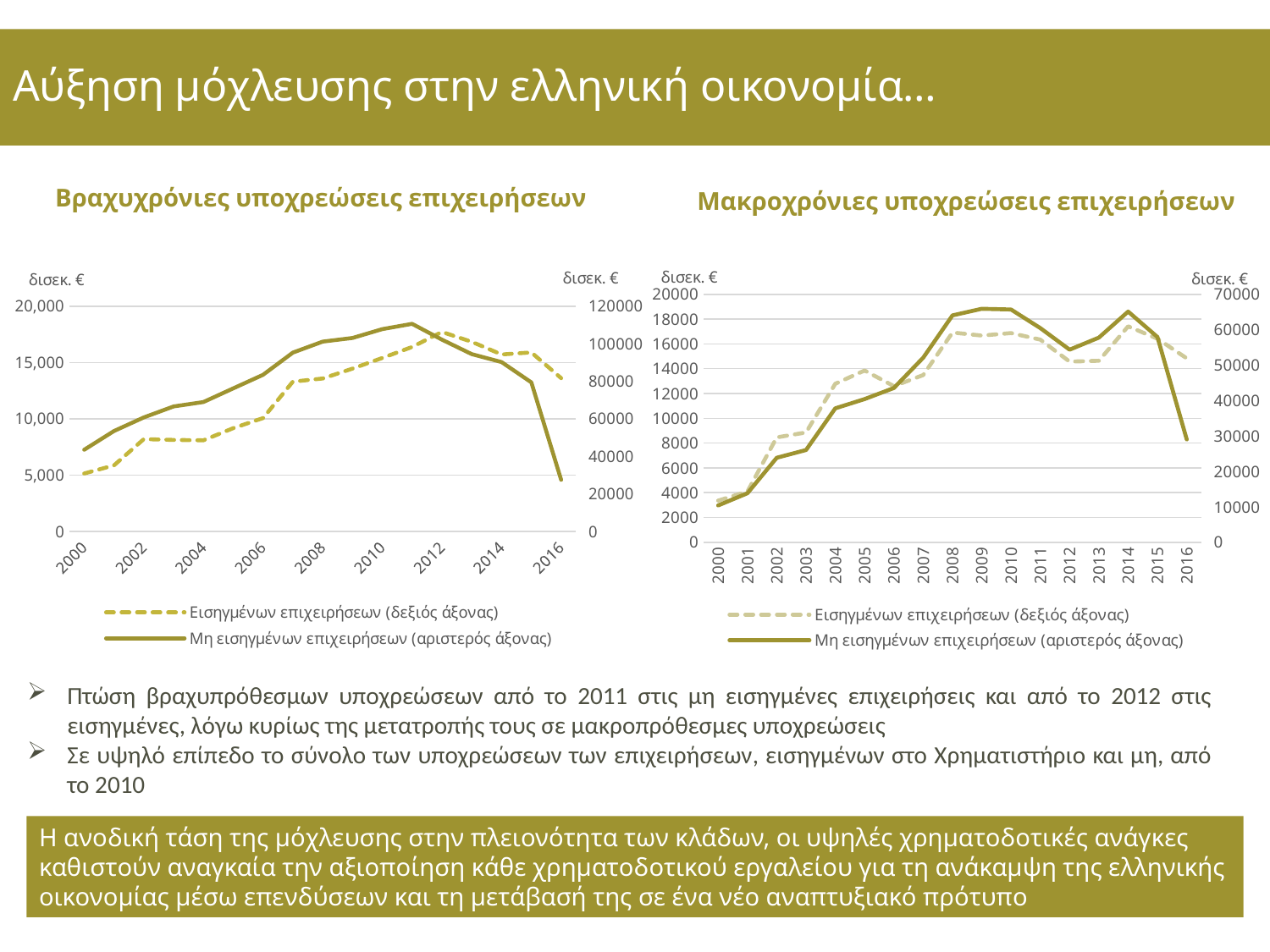
In the right chart 'Μακροχρόνιες υποχρεώσεις επιχειρήσεων', how many years are shown on the x axis? 17 In the left chart 'Βραχυχρόνιες υποχρεώσεις επιχειρήσεων', is the value of the solid line (Μη εισηγμένων επιχειρήσεων) in 2016 greater or less than 10,000? less In the left chart 'Βραχυχρόνιες υποχρεώσεις επιχειρήσεων', is the value of the solid line (Μη εισηγμένων επιχειρήσεων) in 2011 greater or less than 15,000? greater What type of chart is the left chart titled 'Βραχυχρόνιες υποχρεώσεις επιχειρήσεων'? Line chart In the right chart 'Μακροχρόνιες υποχρεώσεις επιχειρήσεων', is the value of the solid line (Μη εισηγμένων επιχειρήσεων) in 2016 greater or less than 10000? less In the right chart 'Μακροχρόνιες υποχρεώσεις επιχειρήσεων', does the solid line (Μη εισηγμένων επιχειρήσεων) rise or fall between 2000 and 2009? rise How many series does the legend of the right chart 'Μακροχρόνιες υποχρεώσεις επιχειρήσεων' list? 2 In the right chart 'Μακροχρόνιες υποχρεώσεις επιχειρήσεων', in which year is the solid line (Μη εισηγμένων επιχειρήσεων) at its lowest? 2000 What unit is shown on the axes of the right chart 'Μακροχρόνιες υποχρεώσεις επιχειρήσεων'? δισεκ. € In the left chart 'Βραχυχρόνιες υποχρεώσεις επιχειρήσεων', does the solid line (Μη εισηγμένων επιχειρήσεων) rise or fall between 2011 and 2016? fall In the left chart 'Βραχυχρόνιες υποχρεώσεις επιχειρήσεων', which series is plotted on the right axis according to the legend? Εισηγμένων επιχειρήσεων